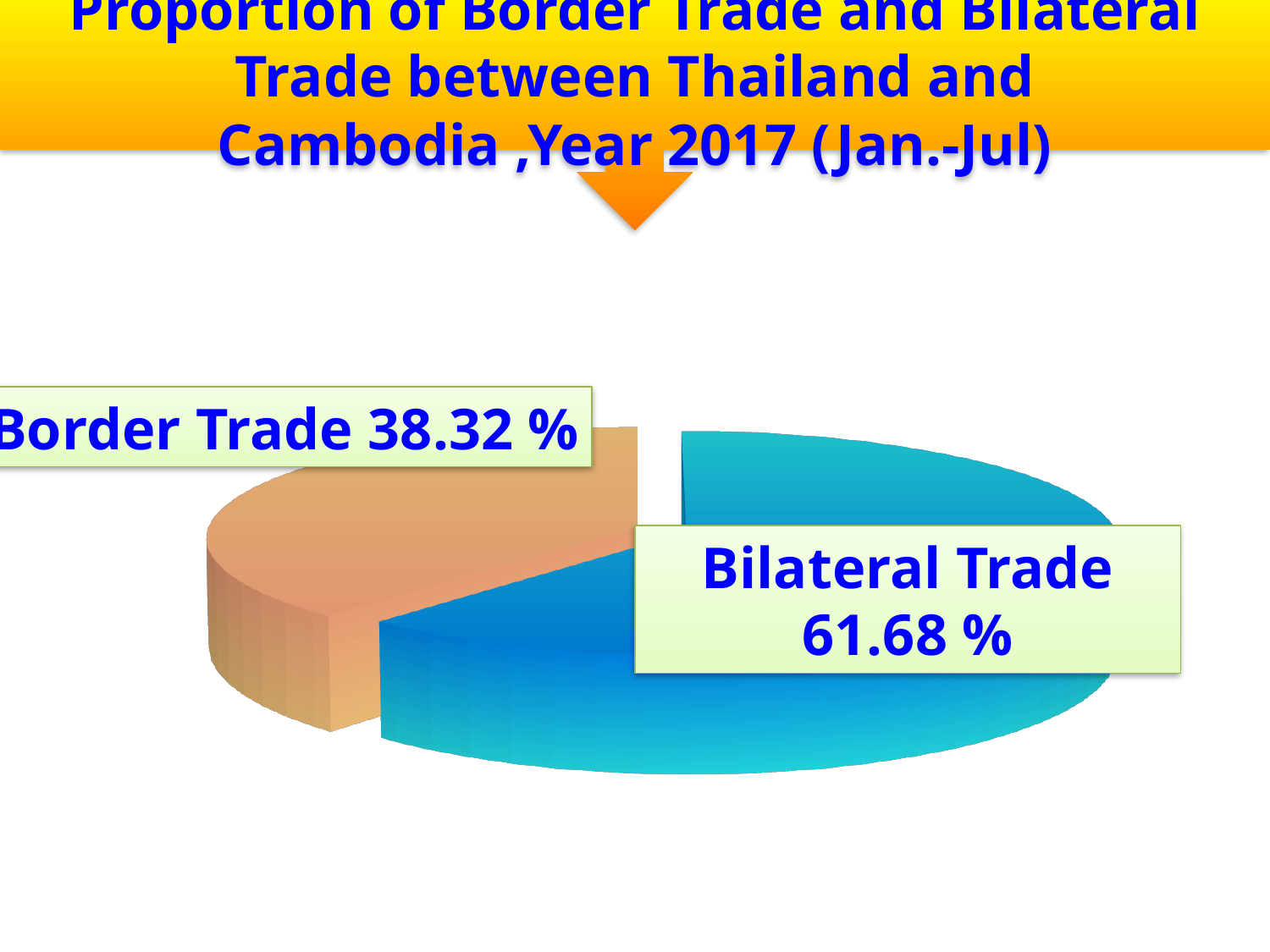
Which slice is the largest? Bilateral Trade Which is larger, Border Trade or Bilateral Trade? Bilateral Trade What share of the pie does Border Trade represent? 38.32 % What kind of chart is shown on the slide? Pie chart What is the difference between the Bilateral Trade and Border Trade percentages? 23.36 % What colour is the Border Trade slice? Orange What is the value for Border Trade? 38.32 % Which slice is the smallest? Border Trade What colour is the Bilateral Trade slice? Blue How many slices does the pie chart have? 2 What is the value for Bilateral Trade? 61.68 %